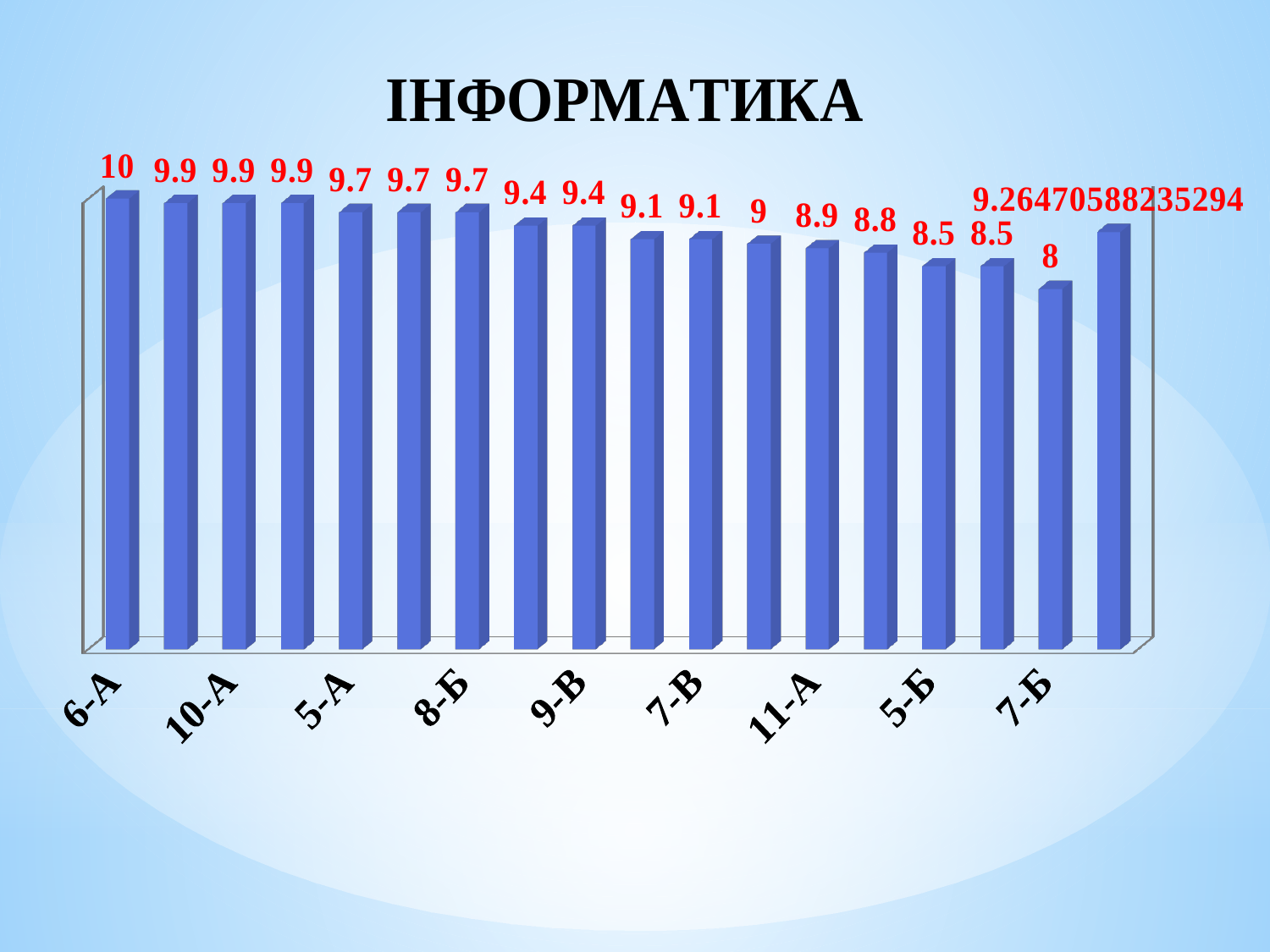
What is the value for 10-А? 9.9 What kind of chart is shown on the slide? Bar chart What is the value for 7-Б? 8 What is the title of the chart? ІНФОРМАТИКА Which is larger, the value for 5-А or the value for 11-А? 5-А What is the value for 9-В? 9.4 What is the value for 6-А? 10 How many bars are plotted in the chart? 18 What is the value for 11-А? 8.9 Which labelled category has the lowest value? 7-Б Which labelled category has the highest value? 6-А What is the difference between the values for 6-А and 7-Б? 2